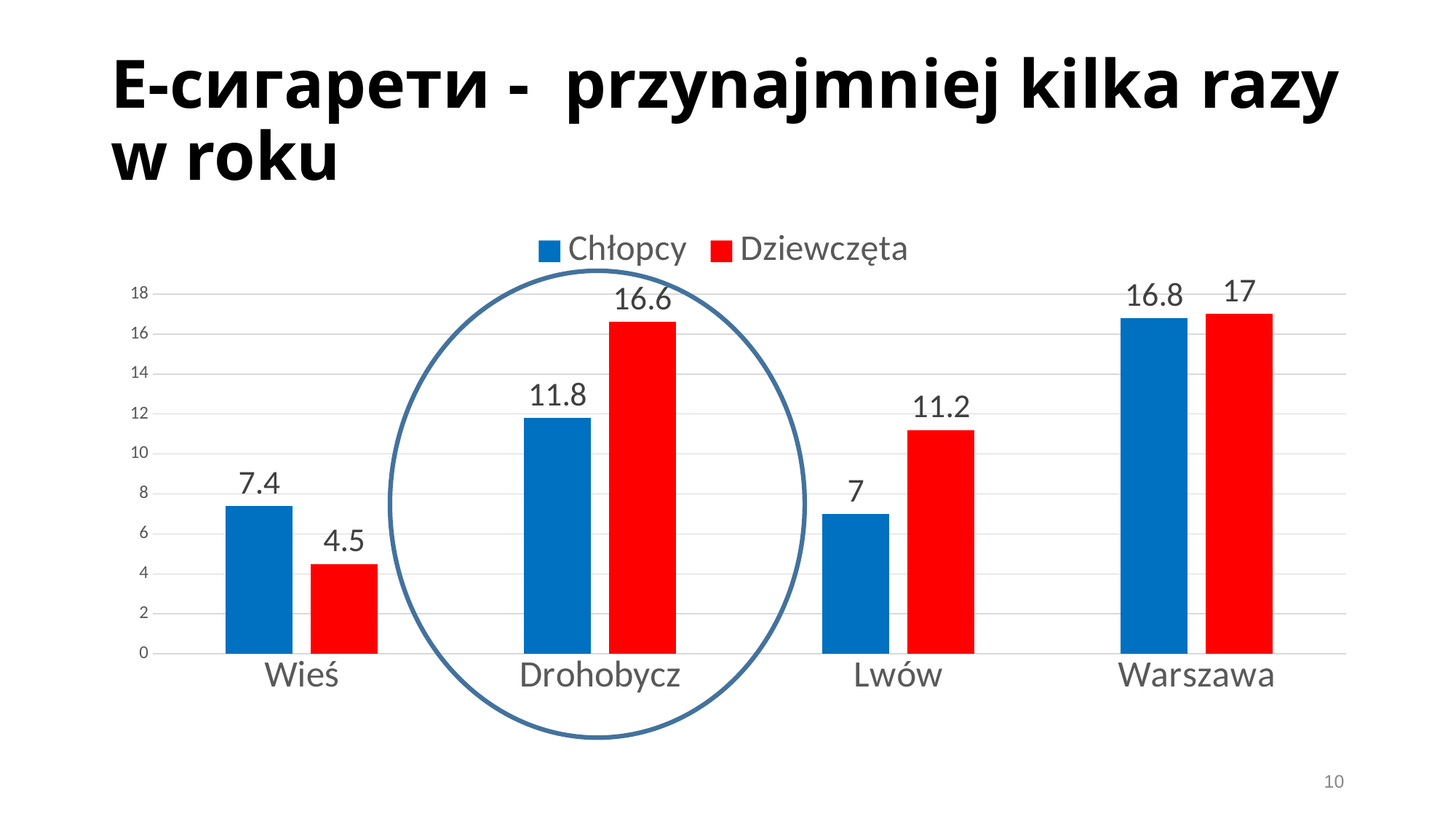
What kind of chart is shown on the slide? bar chart Is the value for Chłopcy in Wieś greater or less than 6? greater What is the value for Dziewczęta in Wieś? 4.5 What is the value for Dziewczęta in Warszawa? 17 How many categories are shown on the x axis? 4 Which category is circled on the chart? Drohobycz Which is larger in Lwów, the value for Chłopcy or for Dziewczęta? Dziewczęta What is the value for Chłopcy in Drohobycz? 11.8 Which category has the highest value for Chłopcy? Warszawa What is the difference between the Dziewczęta and Chłopcy values in Drohobycz? 4.8 How many series does the legend list? 2 Which category has the lowest value for Dziewczęta? Wieś